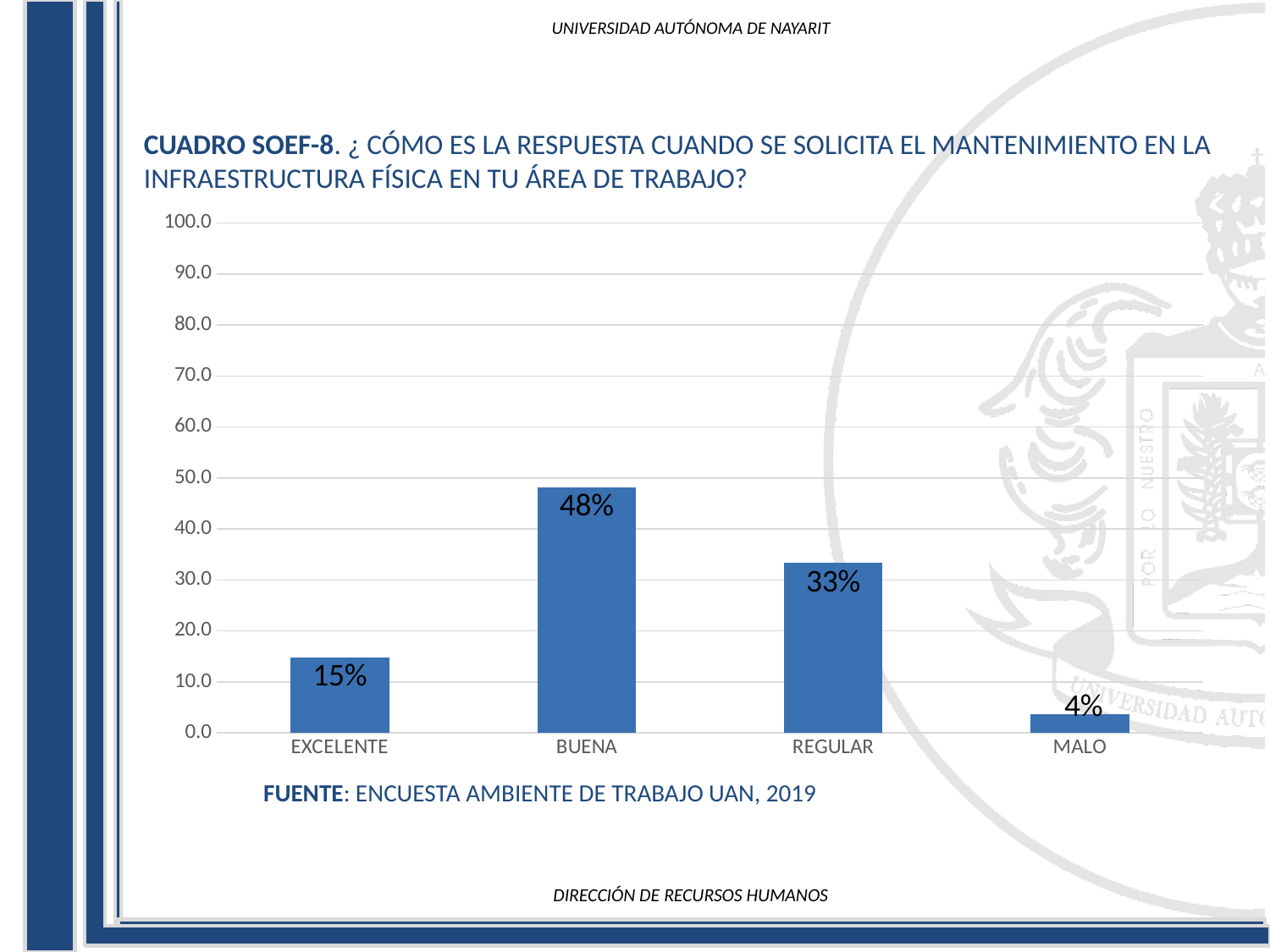
Which category has the lowest value? MALO What kind of chart is shown on the slide? bar chart What is the value for MALO? 4% What is the value for REGULAR? 33% What is the value for BUENA? 48% How many categories are shown on the x axis? 4 Which category has the highest value? BUENA Is the value for REGULAR greater or less than 40.0? less What is the value for EXCELENTE? 15% What source is cited below the chart? ENCUESTA AMBIENTE DE TRABAJO UAN, 2019 Which is larger, the value for EXCELENTE or the value for REGULAR? REGULAR What is the difference between the values for BUENA and REGULAR? 15%